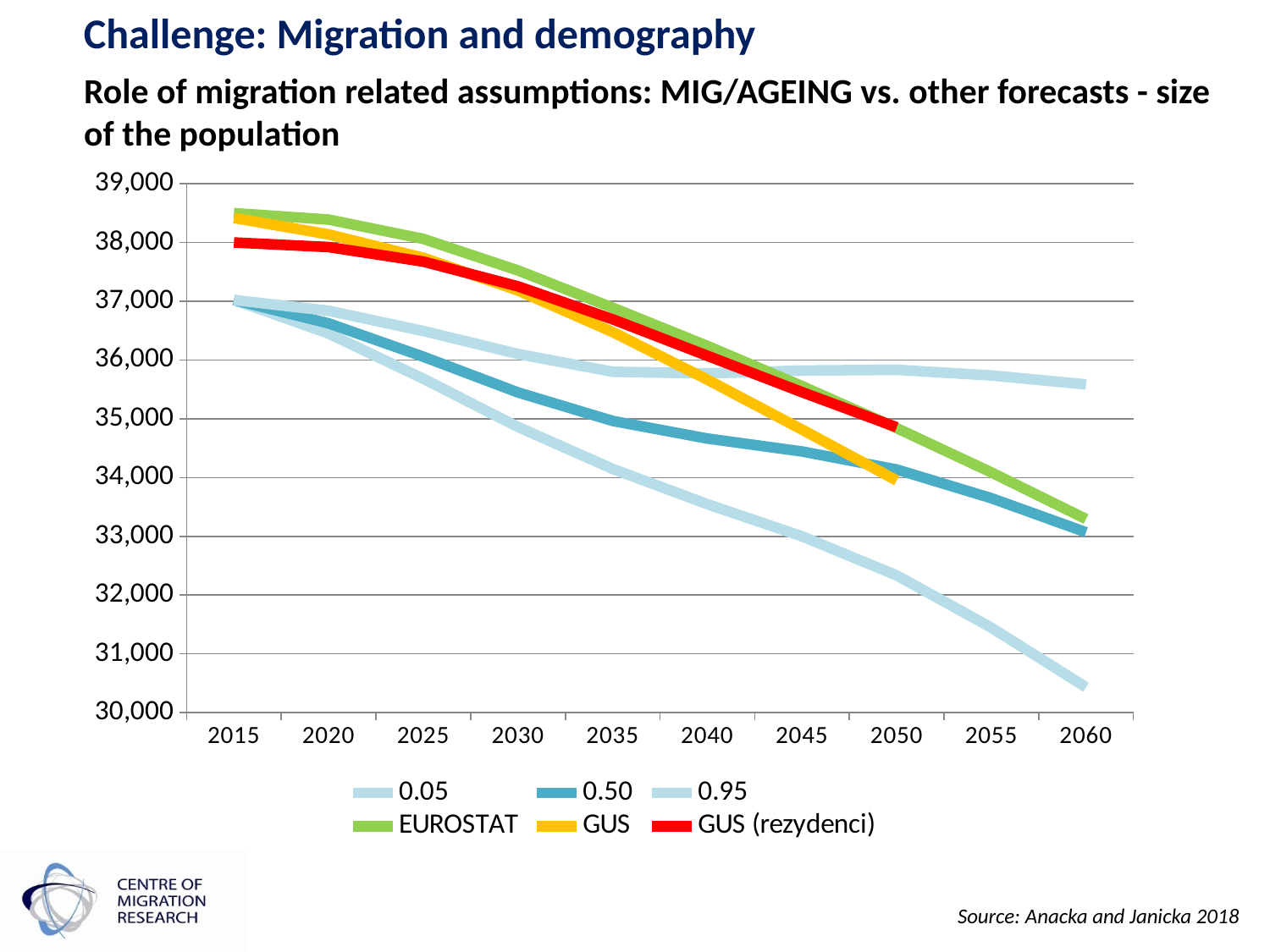
How many series does the legend list? 6 In 2015, which is larger: the EUROSTAT series or the 0.05 series? EUROSTAT What kind of chart is shown on the slide? line chart Does the 0.05 series rise or fall from 2015 to 2060? fall Is the value for 0.05 in 2060 greater or less than 31,000? less Is the value for EUROSTAT in 2015 greater or less than 38,000? greater Which two series end in 2050 rather than 2060? GUS and GUS (rezydenci) Is the value for 0.50 in 2040 greater or less than 35,000? less Which series has the lowest value in 2060? 0.05 In 2060, which is larger: the 0.95 series or the 0.50 series? 0.95 How many years are labelled on the x axis? 10